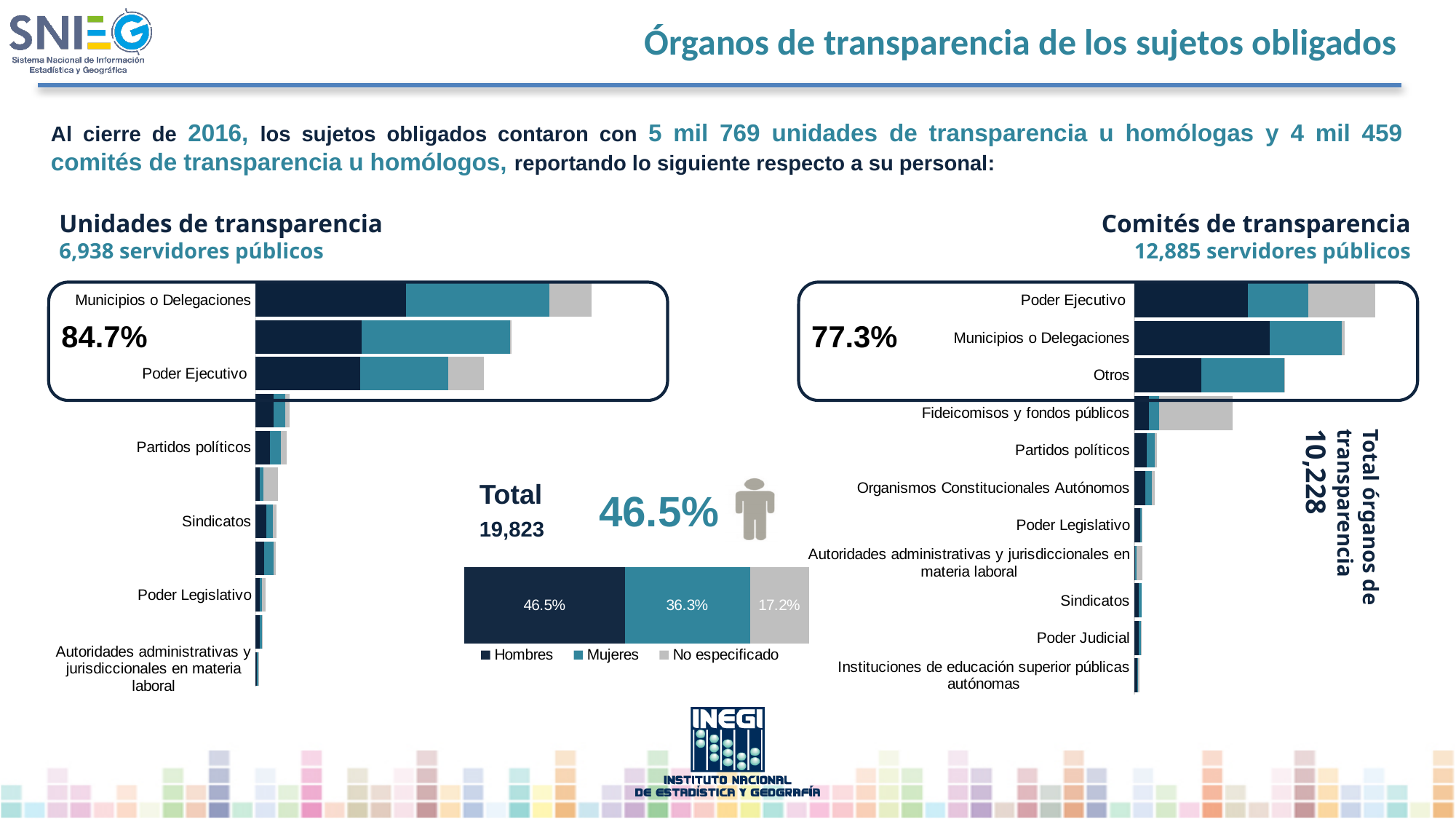
In the 'Comités de transparencia' chart on the right, which category has the shortest bar? Instituciones de educación superior públicas autónomas In the 'Total' chart in the centre, what is the value for Mujeres? 36.3% How many series does the legend under the 'Total' chart list? 3 In the 'Comités de transparencia' chart on the right, which bar is longer: Poder Ejecutivo or Otros? Poder Ejecutivo In the 'Total' chart in the centre, what is the value for No especificado? 17.2% What kind of chart is the 'Unidades de transparencia' chart on the left? Bar chart In the 'Comités de transparencia' chart on the right, which category has the longest bar? Poder Ejecutivo In the 'Unidades de transparencia' chart on the left, which category has the longest bar? Municipios o Delegaciones In the 'Total' chart in the centre, what is the value for Hombres? 46.5% In the 'Total' chart in the centre, which series has the smallest share? No especificado In the 'Comités de transparencia' chart on the right, how many categories are plotted? 11 In the 'Total' chart in the centre, what is the difference between the Hombres and Mujeres values? 10.2 percentage points